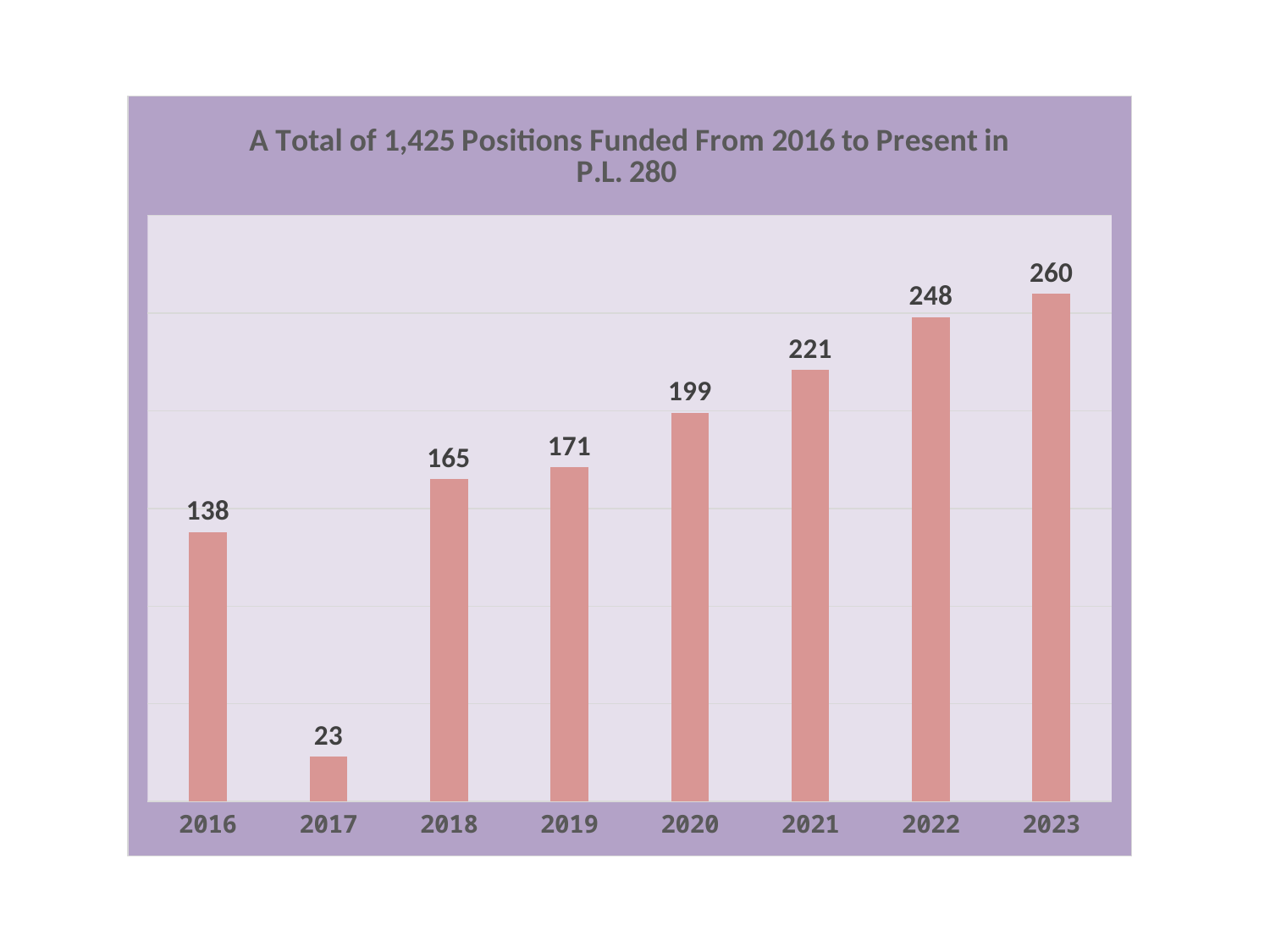
What is the value for 2020? 199 What is the title of the chart? A Total of 1,425 Positions Funded From 2016 to Present in P.L. 280 Which year has the lowest value? 2017 What is the difference between the values for 2023 and 2016? 122 What is the value for 2016? 138 Which is larger, the value for 2021 or the value for 2020? 2021 Do the values rise or fall from 2017 to 2023? rise What is the difference between the values for 2019 and 2018? 6 Which year has the highest value? 2023 How many years are shown on the x axis? 8 What kind of chart is this? bar chart What is the value for 2022? 248